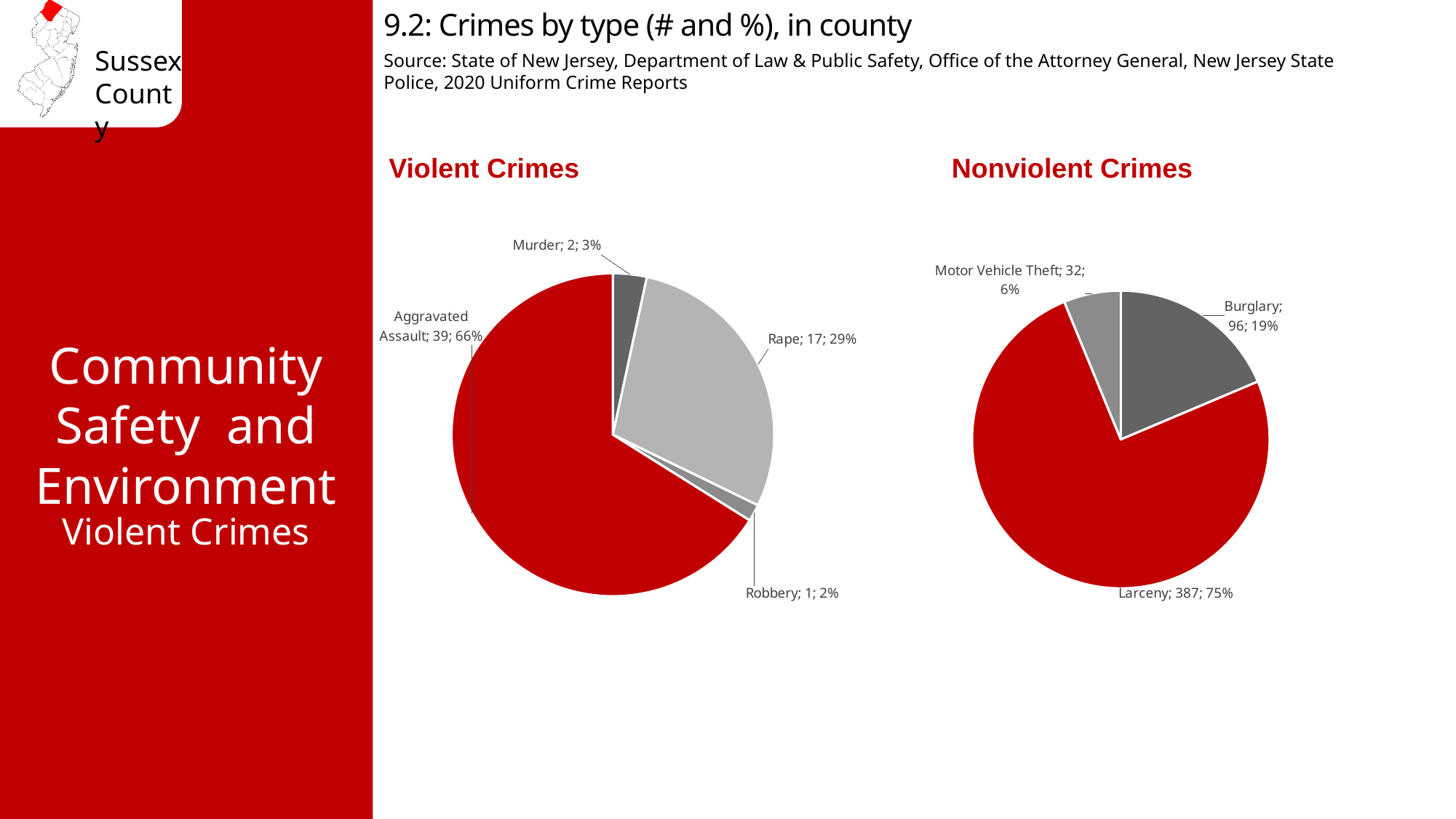
In the Nonviolent Crimes pie chart, how many larcenies are shown? 387 What type of chart is used for the Violent Crimes data? Pie chart In the Violent Crimes pie chart, how many aggravated assaults are shown? 39 In the Violent Crimes pie chart, which category has the largest slice? Aggravated Assault In the Nonviolent Crimes pie chart, is the value for Burglary or Motor Vehicle Theft larger? Burglary In the Violent Crimes pie chart, what share of the pie does Rape represent? 29% In the Violent Crimes pie chart, what is the difference between the number of aggravated assaults and the number of rapes? 22 In the Nonviolent Crimes pie chart, what is the difference between the number of burglaries and the number of motor vehicle thefts? 64 In the Violent Crimes pie chart, which category has the smallest slice? Robbery In the Nonviolent Crimes pie chart, which category has the smallest slice? Motor Vehicle Theft In the Violent Crimes pie chart, how many categories are shown? 4 In the Nonviolent Crimes pie chart, what share of the pie does Burglary represent? 19%